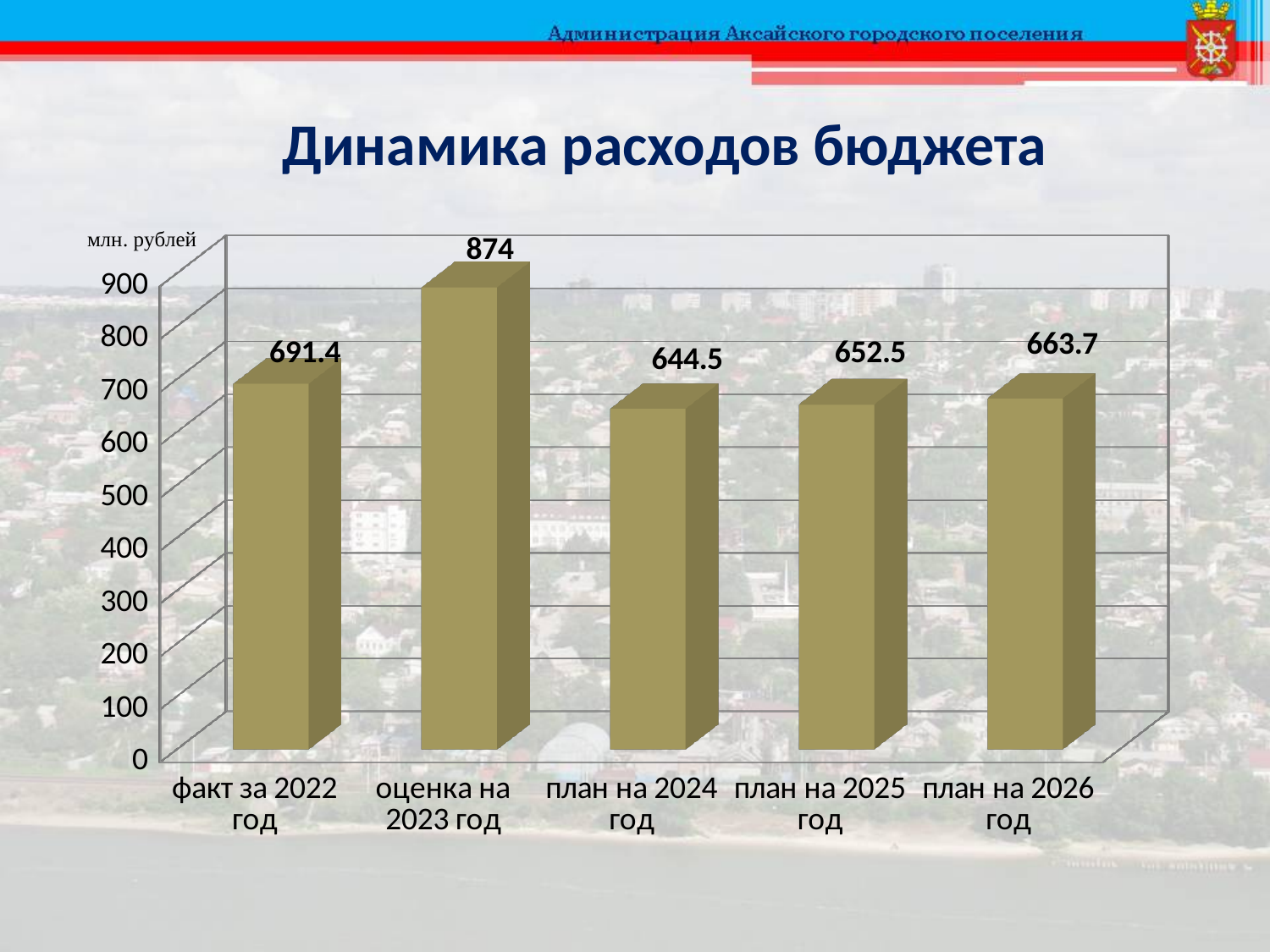
What is the value for "факт за 2022 год"? 691.4 What is the difference between the values for "план на 2026 год" and "план на 2025 год"? 11.2 How many categories are shown on the chart? 5 What is the value for "оценка на 2023 год"? 874 What is the title of the chart? Динамика расходов бюджета Is the value for "план на 2025 год" greater or less than 700? less Which category has the highest value? оценка на 2023 год Which category has the lowest value? план на 2024 год Which is larger: the value for "факт за 2022 год" or "план на 2024 год"? факт за 2022 год What is the value for "план на 2026 год"? 663.7 What is the difference between the values for "оценка на 2023 год" and "факт за 2022 год"? 182.6 What kind of chart is shown on the slide? bar chart